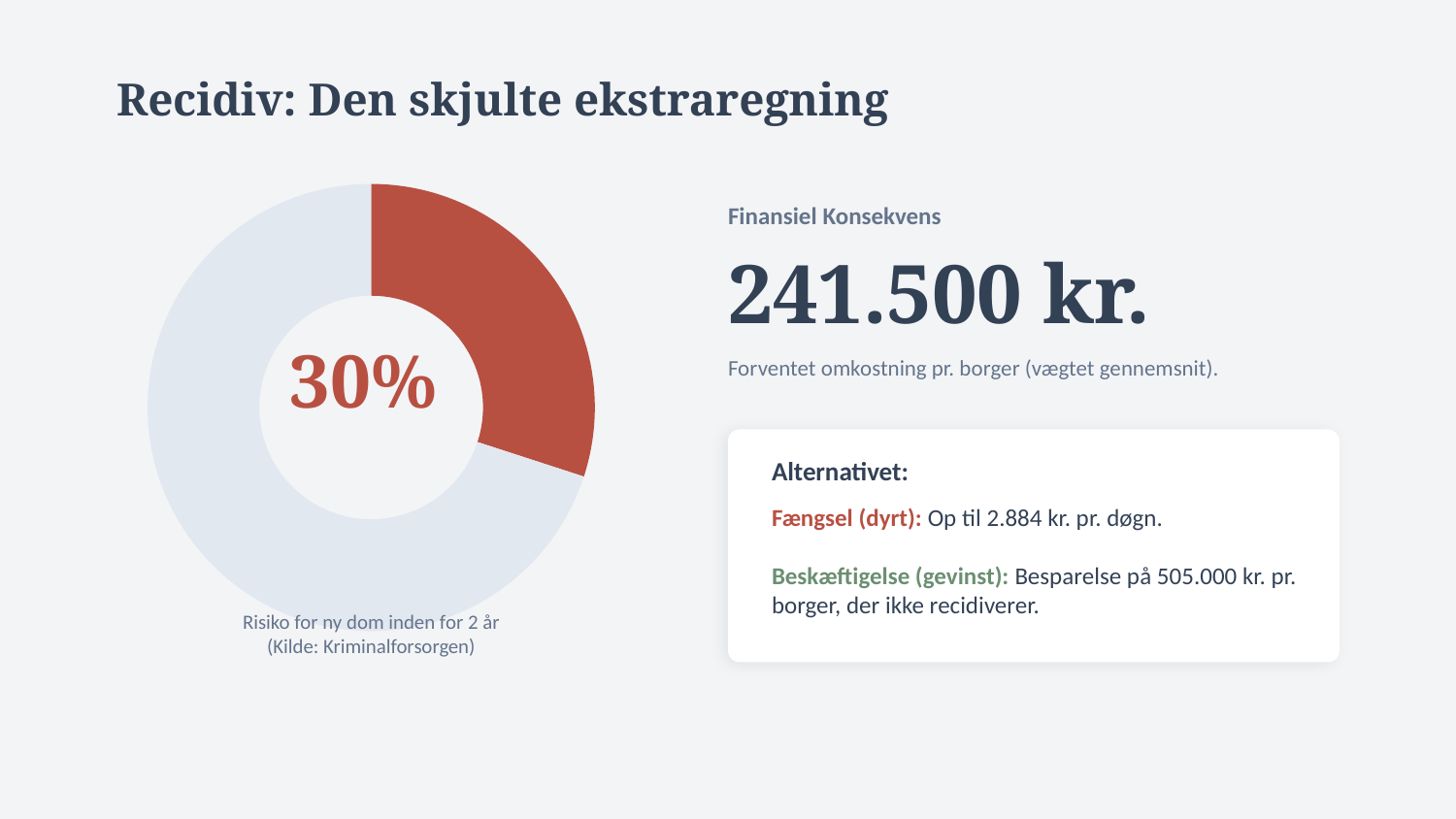
What source is cited below the donut chart? Kriminalforsorgen What kind of chart is shown on the left of the slide? Donut (pie) chart How many slices does the donut chart have? 2 What share of the donut chart is taken up by the light grey remainder? 70% What does the caption below the donut chart say the 30% represents? Risiko for ny dom inden for 2 år Is the red slice of the donut chart greater or less than 50% of the whole? less What percentage is shown in the centre of the donut chart? 30% Which slice of the donut chart is larger, the red slice or the light grey slice? The light grey slice What share of the donut chart does the red (highlighted) slice represent? 30%